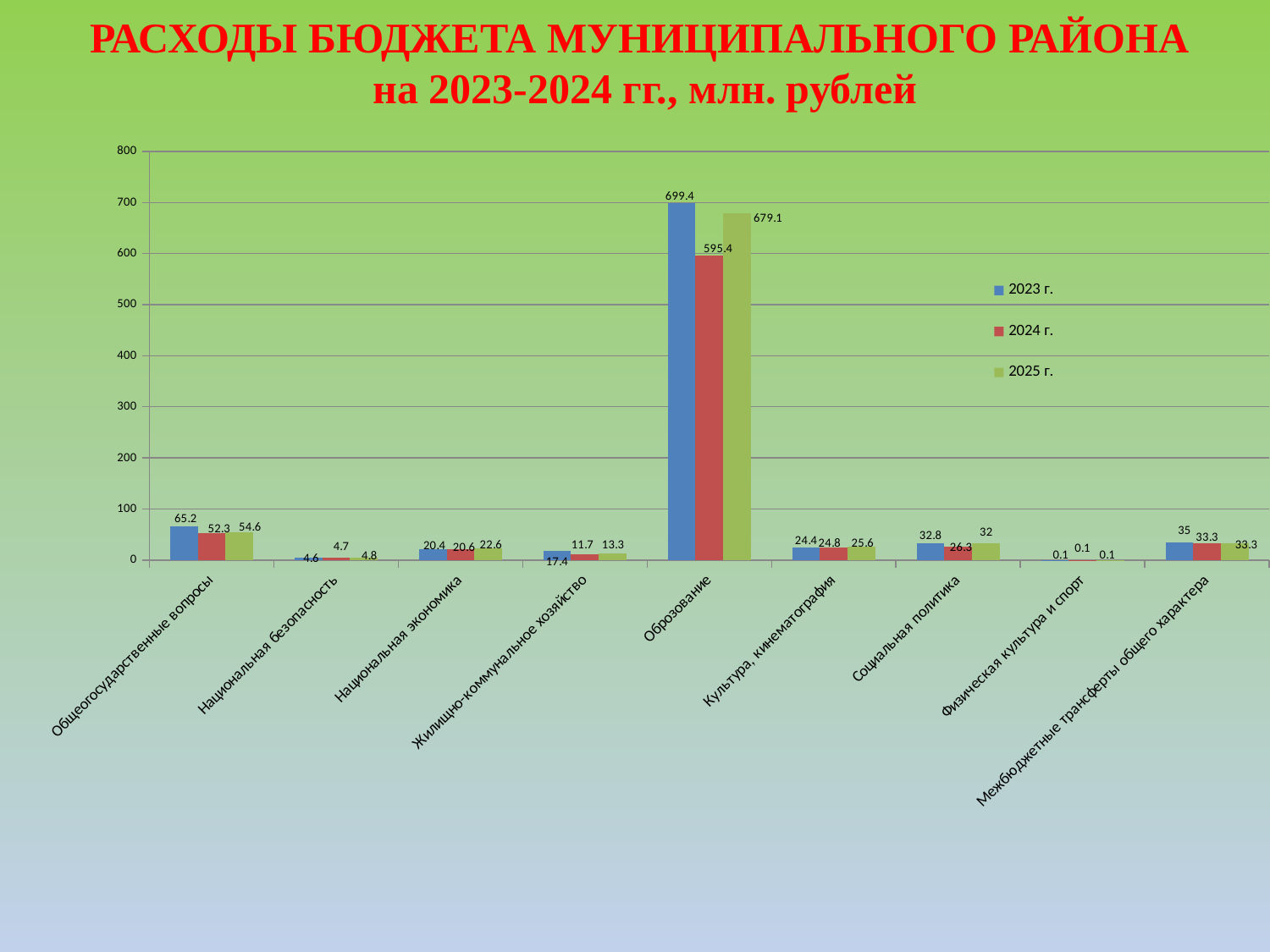
Which is larger for Социальная политика: the 2023 г. value or the 2024 г. value? 2023 г. What is the difference between the 2023 г. and 2024 г. values for Образование? 104 How many series does the legend list? 3 What is the value for Образование in the 2023 г. series? 699.4 Is the 2024 г. value for Образование greater or less than 600? less What kind of chart is shown on the slide? bar chart What is the value for Жилищно-коммунальное хозяйство in the 2025 г. series? 13.3 Which category has the highest value in the 2025 г. series? Образование Which category has the lowest value in the 2023 г. series? Физическая культура и спорт How many categories are shown on the x axis? 9 What is the value for Общегосударственные вопросы in the 2024 г. series? 52.3 What is the value for Межбюджетные трансферты общего характера in the 2023 г. series? 35